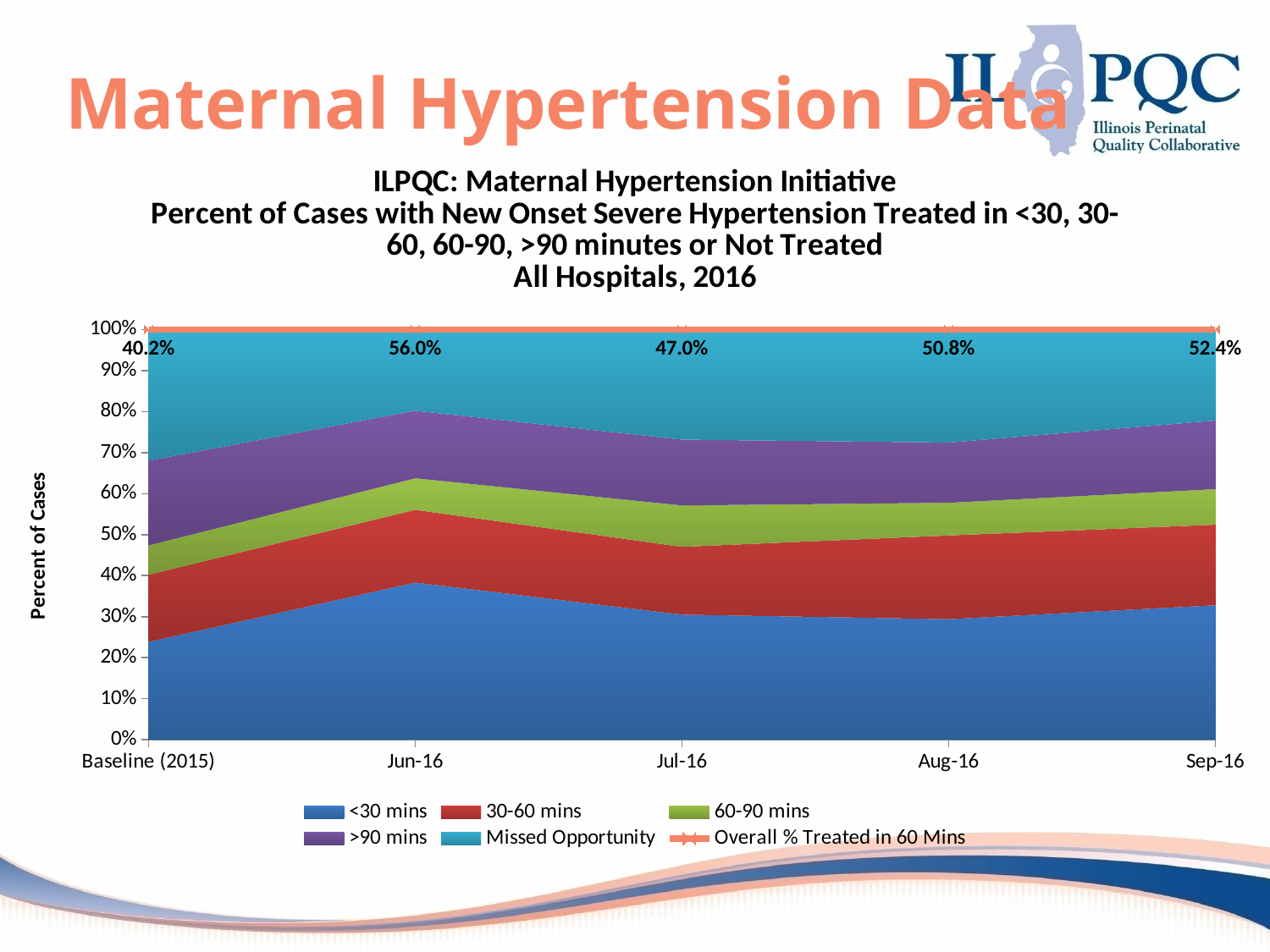
How many series does the legend list? 6 What is the Overall % Treated in 60 Mins value for Jun-16? 56.0% Is the value for <30 mins at Baseline (2015) greater or less than 30%? less What is the Overall % Treated in 60 Mins value at Baseline (2015)? 40.2% Does the Overall % Treated in 60 Mins rise or fall from Jun-16 to Jul-16? Fall Which time period has the highest Overall % Treated in 60 Mins? Jun-16 How many time periods are shown on the x axis? 5 What is the difference between the Overall % Treated in 60 Mins at Jun-16 and at Baseline (2015)? 15.8 percentage points What is the Overall % Treated in 60 Mins value for Sep-16? 52.4% Which has a higher Overall % Treated in 60 Mins, Jul-16 or Aug-16? Aug-16 What kind of chart is shown on the slide? Stacked area chart Which time period has the lowest Overall % Treated in 60 Mins? Baseline (2015)